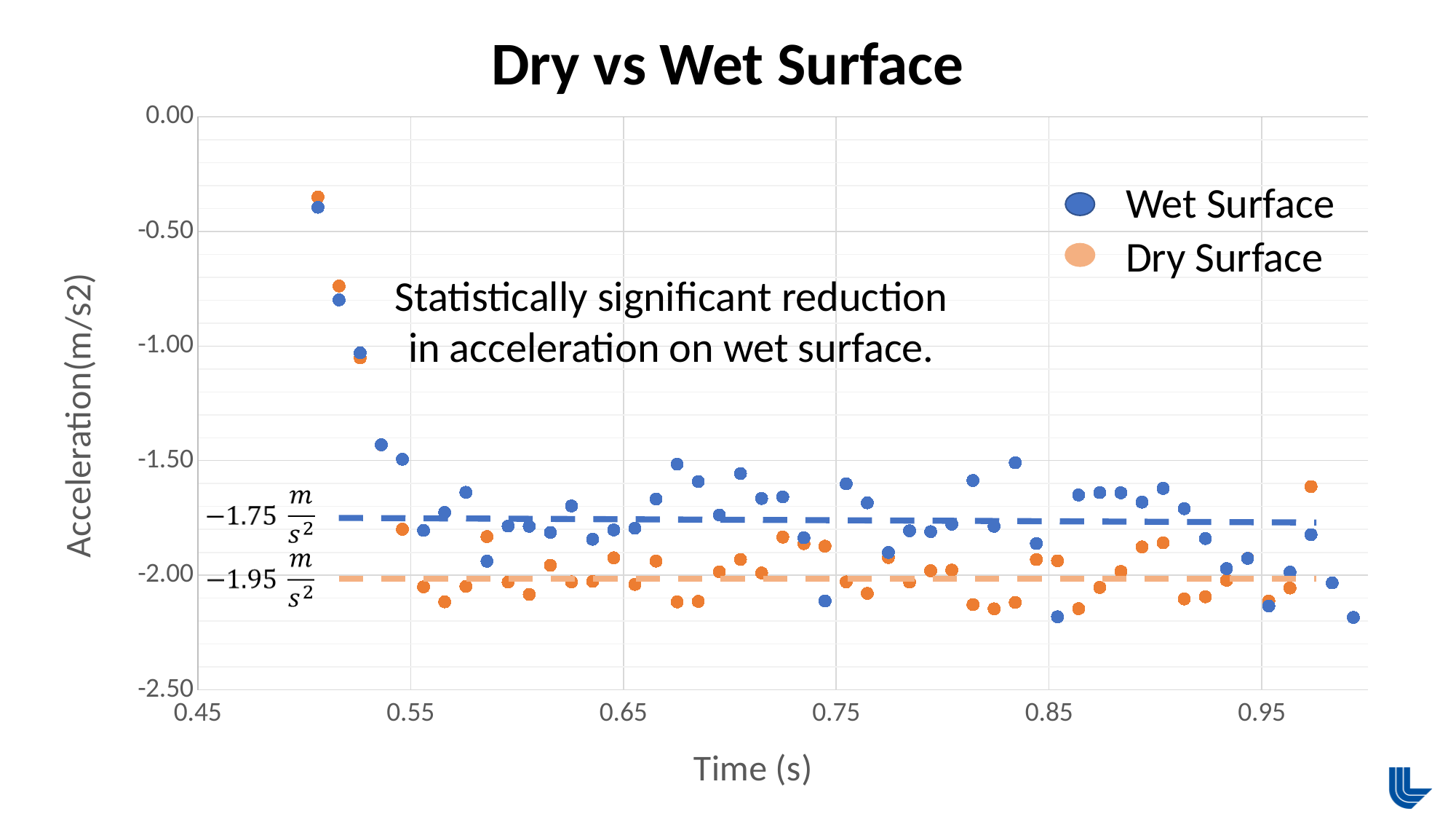
Which labelled dashed-line value is higher, Wet Surface or Dry Surface? Wet Surface What value is labelled on the orange dashed line for the Dry Surface series? -1.95 m/s² Which series is shown in blue according to the legend? Wet Surface What is the label of the x axis? Time (s) Do the acceleration values generally rise or fall as time increases from 0.50 s to 0.55 s? fall What value is labelled on the blue dashed line for the Wet Surface series? -1.75 m/s² Is the Wet Surface value at the first plotted time (about 0.50 s) greater or less than -0.50? greater What is the difference between the labelled dashed-line values for Wet Surface (-1.75) and Dry Surface (-1.95)? 0.20 m/s² What kind of chart is shown on the slide? scatter chart Is the Dry Surface value at about 0.97 s greater or less than -2.00? greater What is the title of the chart? Dry vs Wet Surface How many series does the legend list? 2